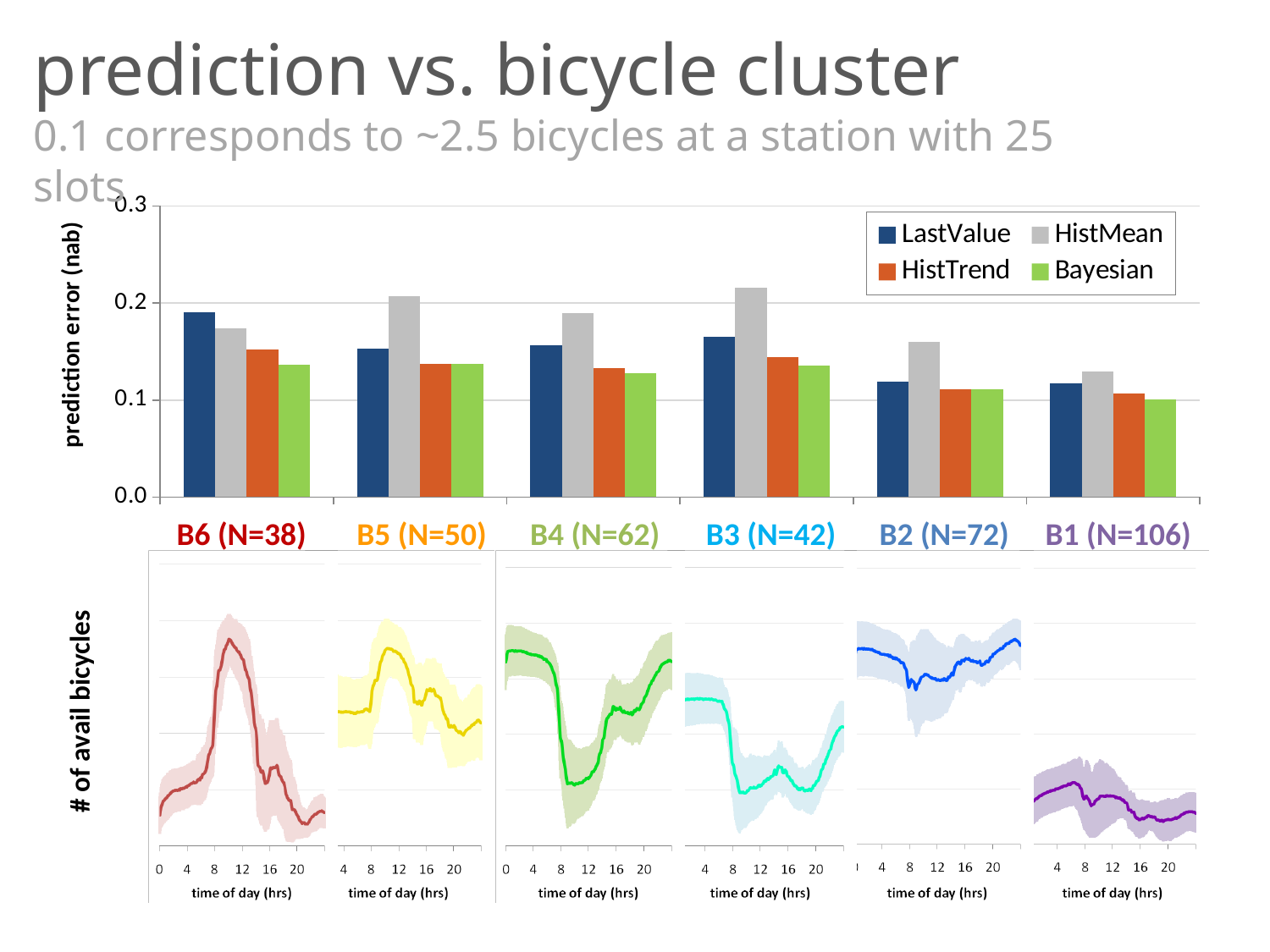
In the upper bar chart, how many bicycle clusters are shown on the x axis? 6 In the upper bar chart, which cluster has the lowest HistMean prediction error? B1 (N=106) In the upper bar chart, which series has the highest prediction error for cluster B3 (N=42)? HistMean In the upper bar chart, how many series does the legend list? 4 In the upper bar chart, which cluster has the highest HistMean prediction error? B3 (N=42) In the upper bar chart, is the HistMean prediction error for B3 (N=42) greater or less than 0.2? greater What is the y-axis label of the upper bar chart? prediction error (nab) In the upper bar chart, is the LastValue prediction error for B6 (N=38) greater or less than 0.2? less In the upper bar chart, for cluster B2 (N=72), which is larger: the HistMean error or the LastValue error? HistMean In the upper bar chart, which series has the highest prediction error for cluster B6 (N=38)? LastValue What kind of chart is the upper chart showing prediction error? bar chart What is the x-axis label of the lower line charts showing # of avail bicycles? time of day (hrs)